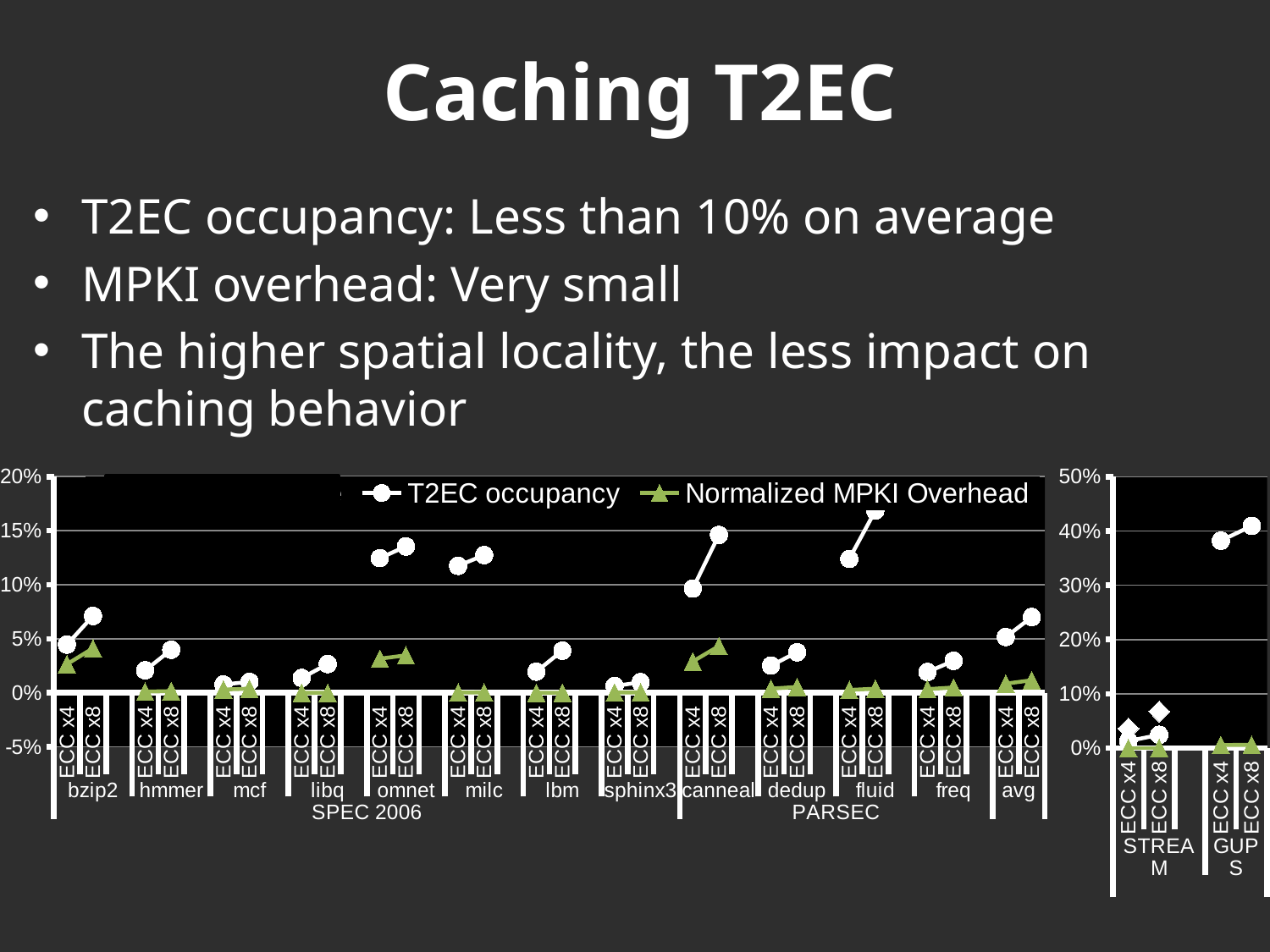
On the right chart, is the T2EC occupancy for GUPS ECC x4 greater or less than 30%? greater On the left chart, is the T2EC occupancy for bzip2 ECC x8 greater or less than 10%? less On the left chart, which has the larger T2EC occupancy: canneal ECC x8 or dedup ECC x8? canneal ECC x8 On the left chart, is the T2EC occupancy for omnet ECC x4 greater or less than 10%? greater What are the two series named in the legend of the left chart? T2EC occupancy and Normalized MPKI Overhead On the right chart, does the T2EC occupancy for GUPS rise or fall from ECC x4 to ECC x8? rise On the right chart, how many benchmark groups are shown along the x axis? 2 On the left chart, how many benchmark groups are shown along the x axis (including avg)? 13 How many series does the legend list on the left chart? 2 What kind of chart is the left chart (SPEC 2006 / PARSEC)? line chart